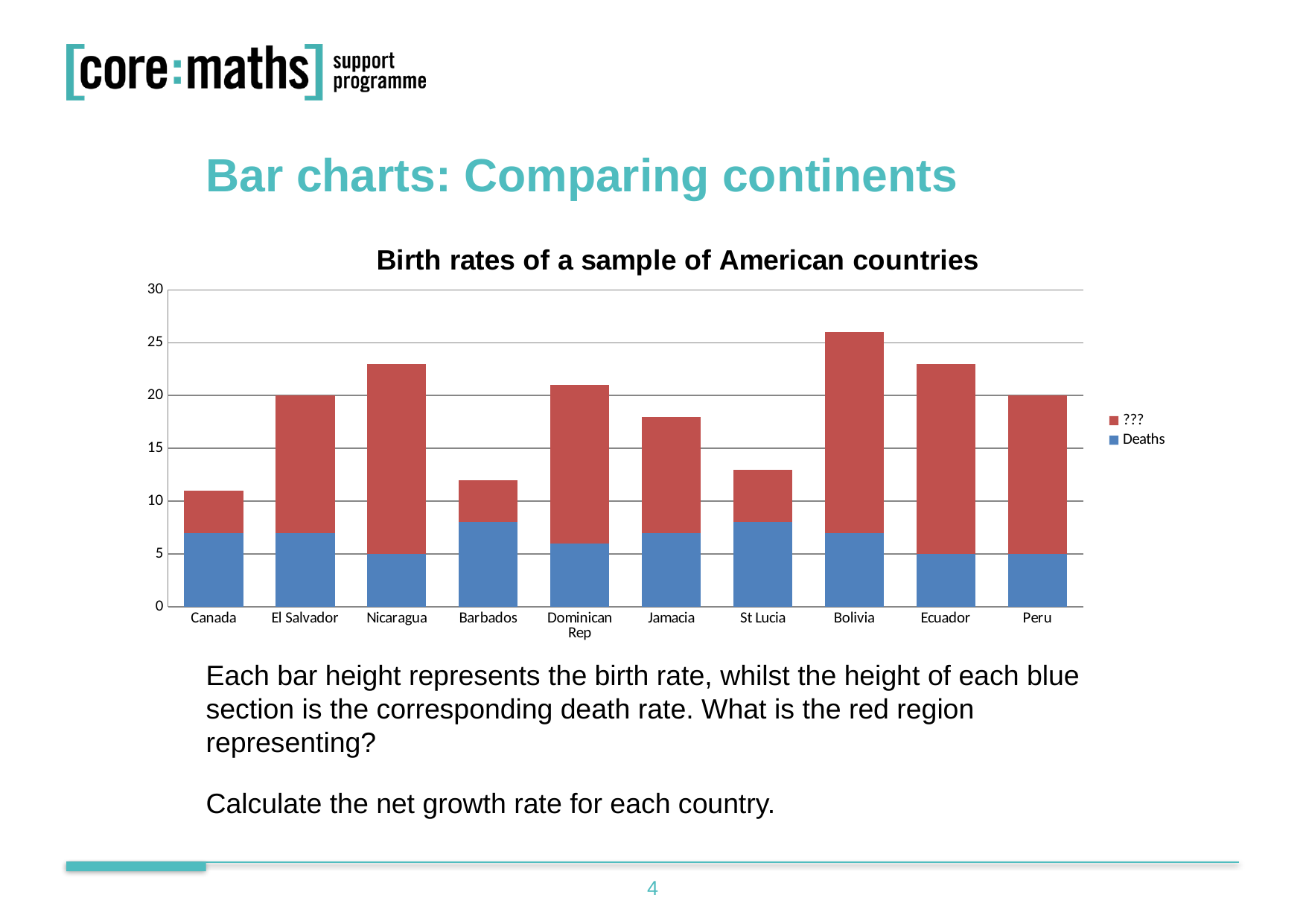
Which country has the tallest bar in the chart? Bolivia Is the total bar height for Bolivia greater or less than 25? greater How many countries are shown on the x axis of the chart? 10 What label does the legend give to the red series? ??? What is the Deaths value for Peru? 5 What kind of chart is shown on the slide? Bar chart Which country has the shortest bar in the chart? Canada What is the total height of the bar for El Salvador? 20 Which has the taller bar, Nicaragua or Jamacia? Nicaragua What is the title of the chart? Birth rates of a sample of American countries Is the total bar height for Barbados greater or less than 15? less How many series does the chart's legend list? 2